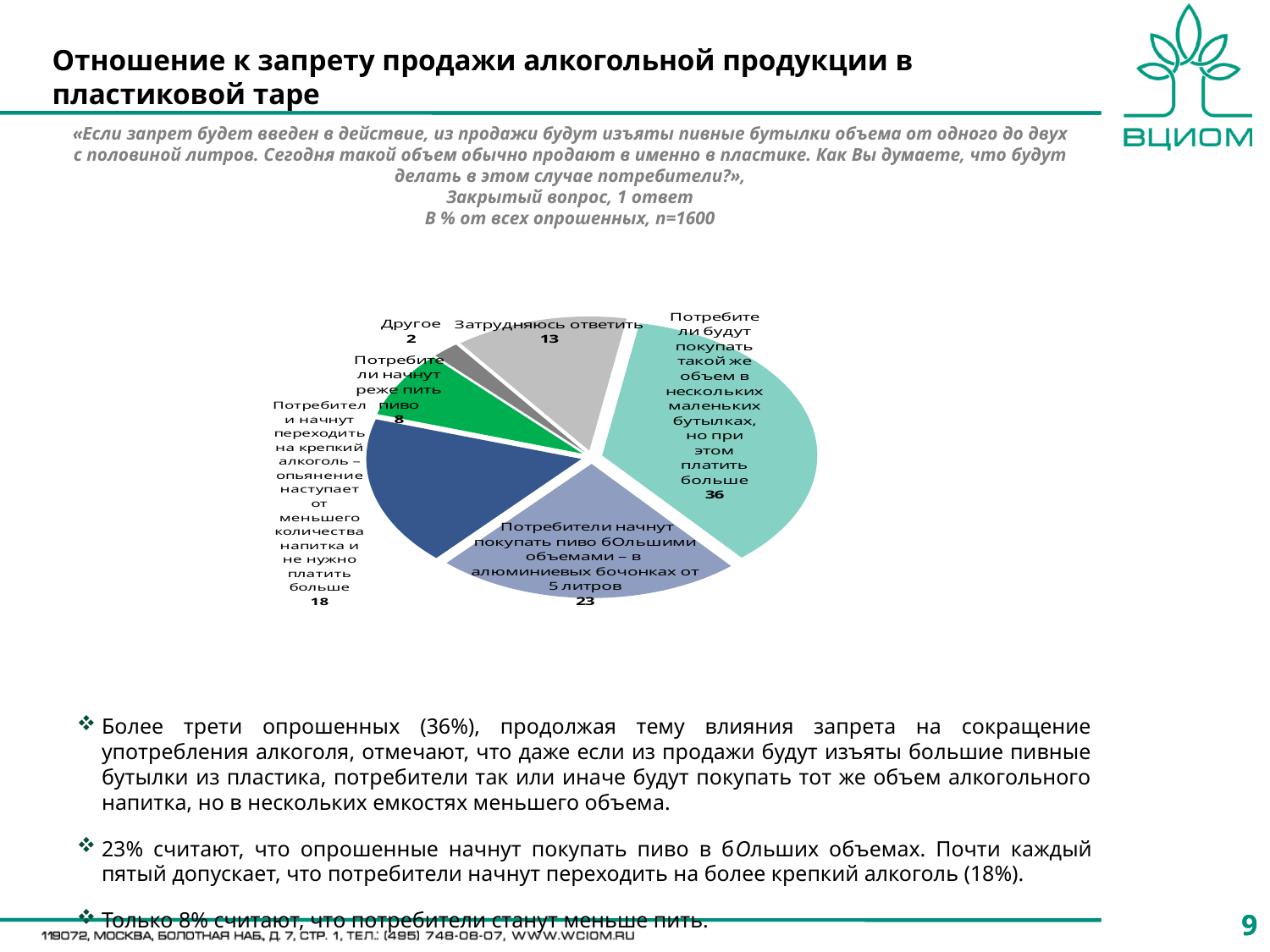
Which slice of the pie chart is the largest? Потребители будут покупать такой же объем в нескольких маленьких бутылках, но при этом платить больше What type of chart is shown on the slide? pie chart What is the difference between the largest slice (36) and the slice for buying beer in larger volumes (23)? 13 Which is larger: the slice for switching to strong alcohol or the slice for "Затрудняюсь ответить"? Потребители начнут переходить на крепкий алкоголь What is the sample size (n) stated in the chart subtitle? n=1600 What is the value for the slice "Затрудняюсь ответить"? 13 What is the value for the slice "Другое"? 2 Which slice of the pie chart is the smallest? Другое What is the value for the slice "Потребители начнут реже пить пиво"? 8 How many slices does the pie chart have? 6 What is the value for the slice "Потребители начнут покупать пиво бОльшими объемами – в алюминиевых бочонках от 5 литров"? 23 What share of the pie does the slice "Потребители начнут переходить на крепкий алкоголь" represent? 18%